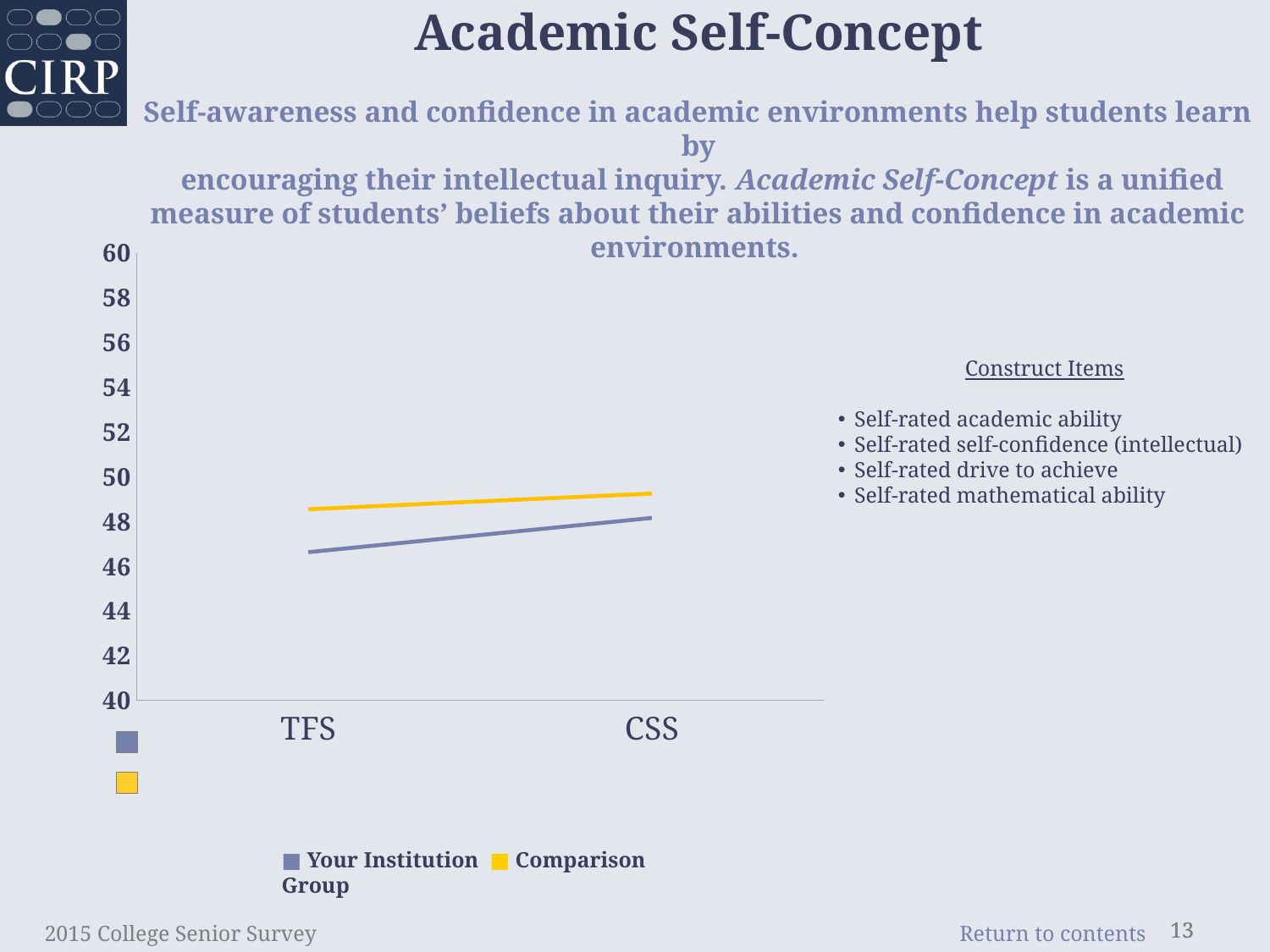
Does the Your Institution line rise or fall from TFS to CSS? rise Is the value for Comparison Group at TFS greater or less than 48? greater How many series does the chart's legend list? 2 Is the value for Your Institution at TFS greater or less than 46? greater At CSS, which series has the higher value, Your Institution or Comparison Group? Comparison Group What kind of chart is shown on the slide? line chart At TFS, which series has the higher value, Your Institution or Comparison Group? Comparison Group How many categories are shown on the x axis of the chart? 2 Is the value for Comparison Group at CSS greater or less than 50? less Which series is plotted in yellow? Comparison Group What is the title of the slide containing the chart? Academic Self-Concept